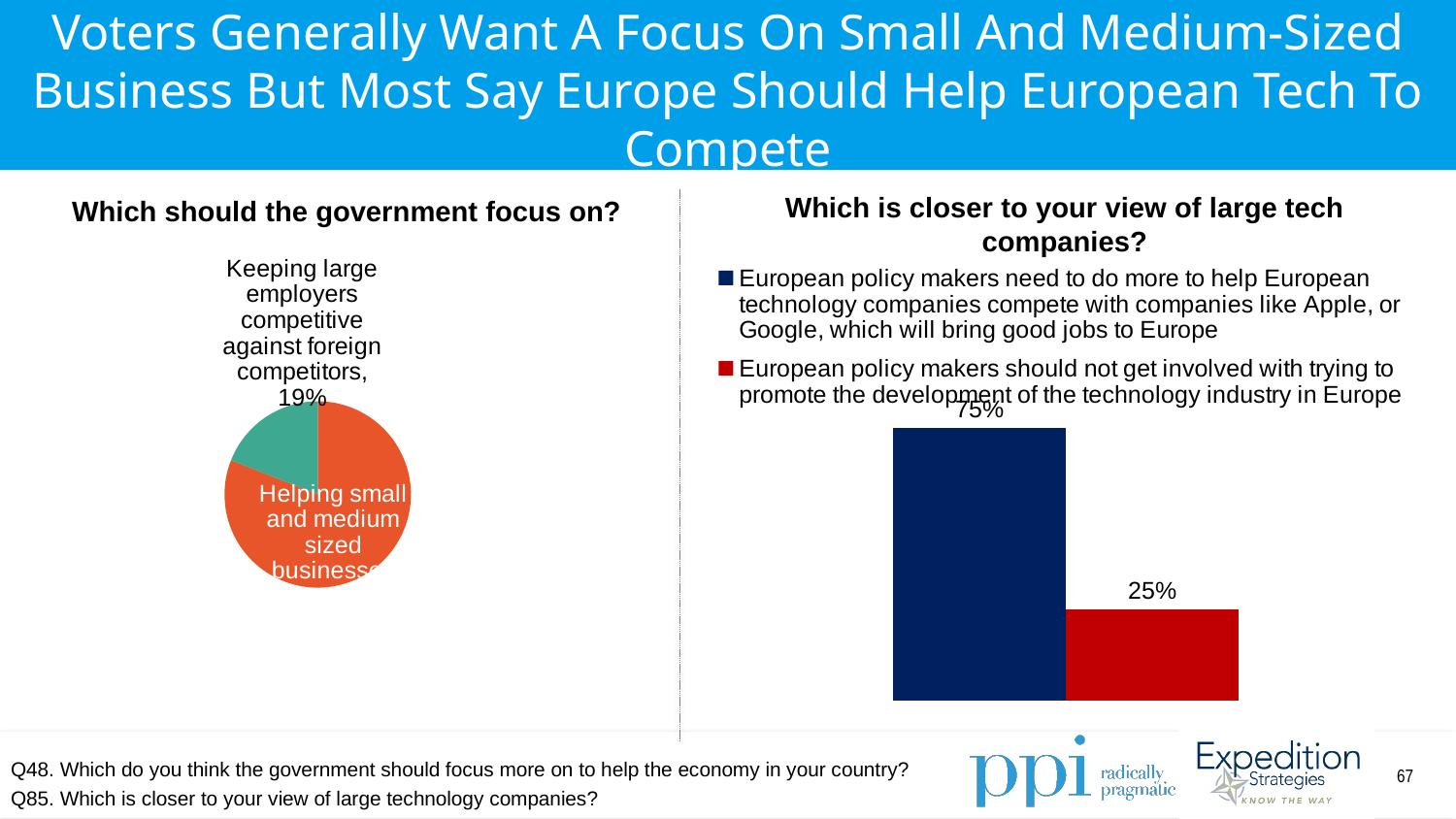
In the chart 'Which is closer to your view of large tech companies?', which response has the highest value? European policy makers need to do more to help European technology companies compete What type of chart is used for 'Which is closer to your view of large tech companies?' Bar chart In the chart 'Which is closer to your view of large tech companies?', which response has the lowest value? European policy makers should not get involved with trying to promote the development of the technology industry in Europe In the chart 'Which is closer to your view of large tech companies?', what colour is the bar for 'European policy makers should not get involved'? Red In the pie chart 'Which should the government focus on?', which slice is larger: 'Helping small and medium sized businesses' or 'Keeping large employers competitive against foreign competitors'? Helping small and medium sized businesses In the chart 'Which is closer to your view of large tech companies?', what is the difference in percentage points between the two responses? 50 percentage points What type of chart is used for 'Which should the government focus on?' Pie chart In the chart 'Which is closer to your view of large tech companies?', how many series does the legend list? 2 In the chart 'Which is closer to your view of large tech companies?', what percentage say European policy makers need to do more to help European technology companies compete? 75% In the chart 'Which is closer to your view of large tech companies?', what percentage say European policy makers should not get involved with trying to promote the development of the technology industry in Europe? 25% In the pie chart 'Which should the government focus on?', what percentage chose 'Keeping large employers competitive against foreign competitors'? 19% In the pie chart 'Which should the government focus on?', how many slices are shown? 2